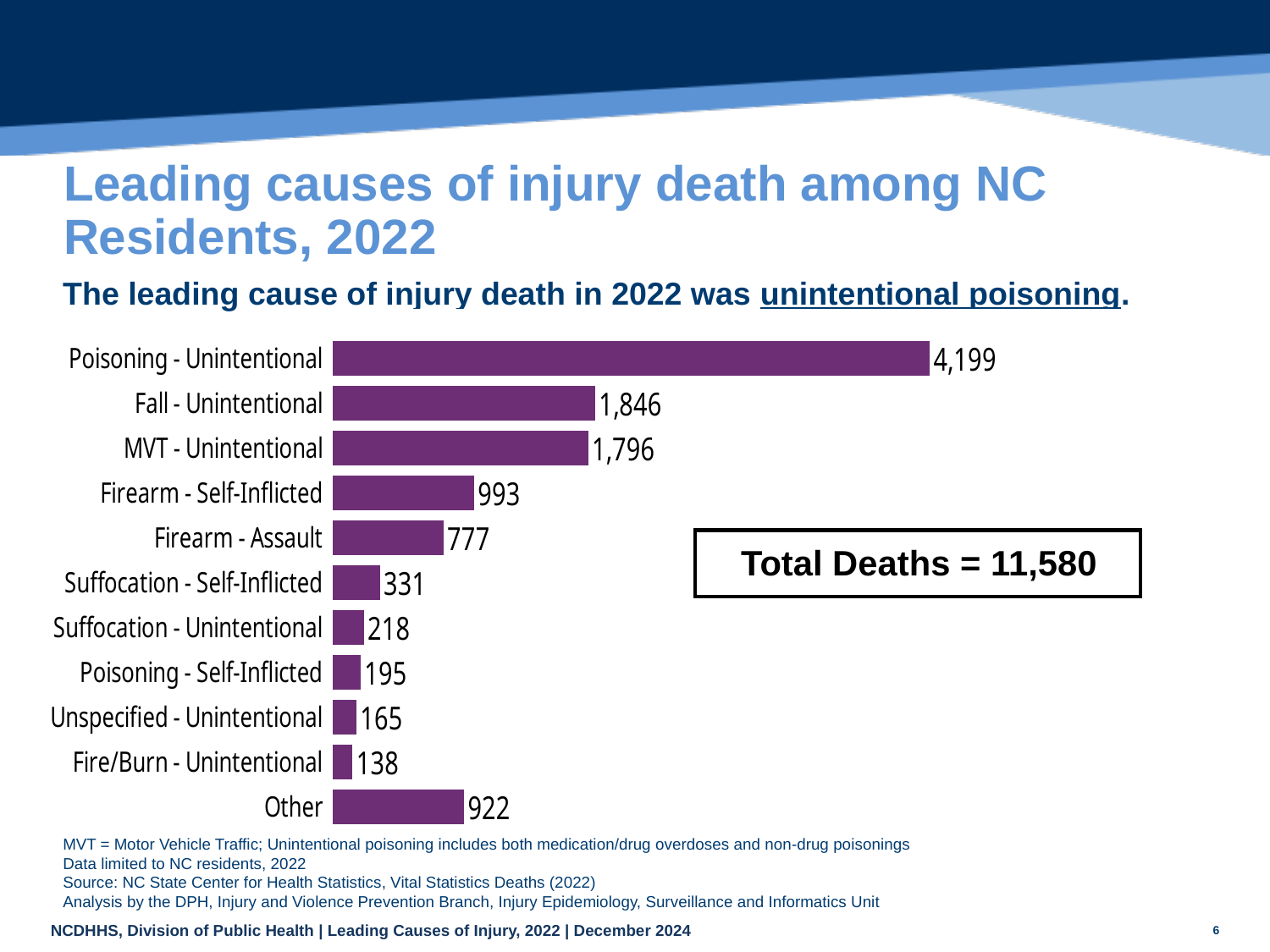
Which is larger, Firearm - Self-Inflicted or Other? Firearm - Self-Inflicted What is the value for Suffocation - Unintentional? 218 What is the difference between Fall - Unintentional and MVT - Unintentional? 50 What is the value for Firearm - Assault? 777 What kind of chart is shown on the slide? Bar chart What total number of deaths is stated in the box next to the chart? 11,580 Which is larger, Poisoning - Self-Inflicted or Suffocation - Self-Inflicted? Suffocation - Self-Inflicted Which category has the lowest value? Fire/Burn - Unintentional Which category has the highest value? Poisoning - Unintentional How many categories are shown in the chart? 11 What is the value for Poisoning - Unintentional? 4,199 What is the difference between Poisoning - Unintentional and Fall - Unintentional? 2,353